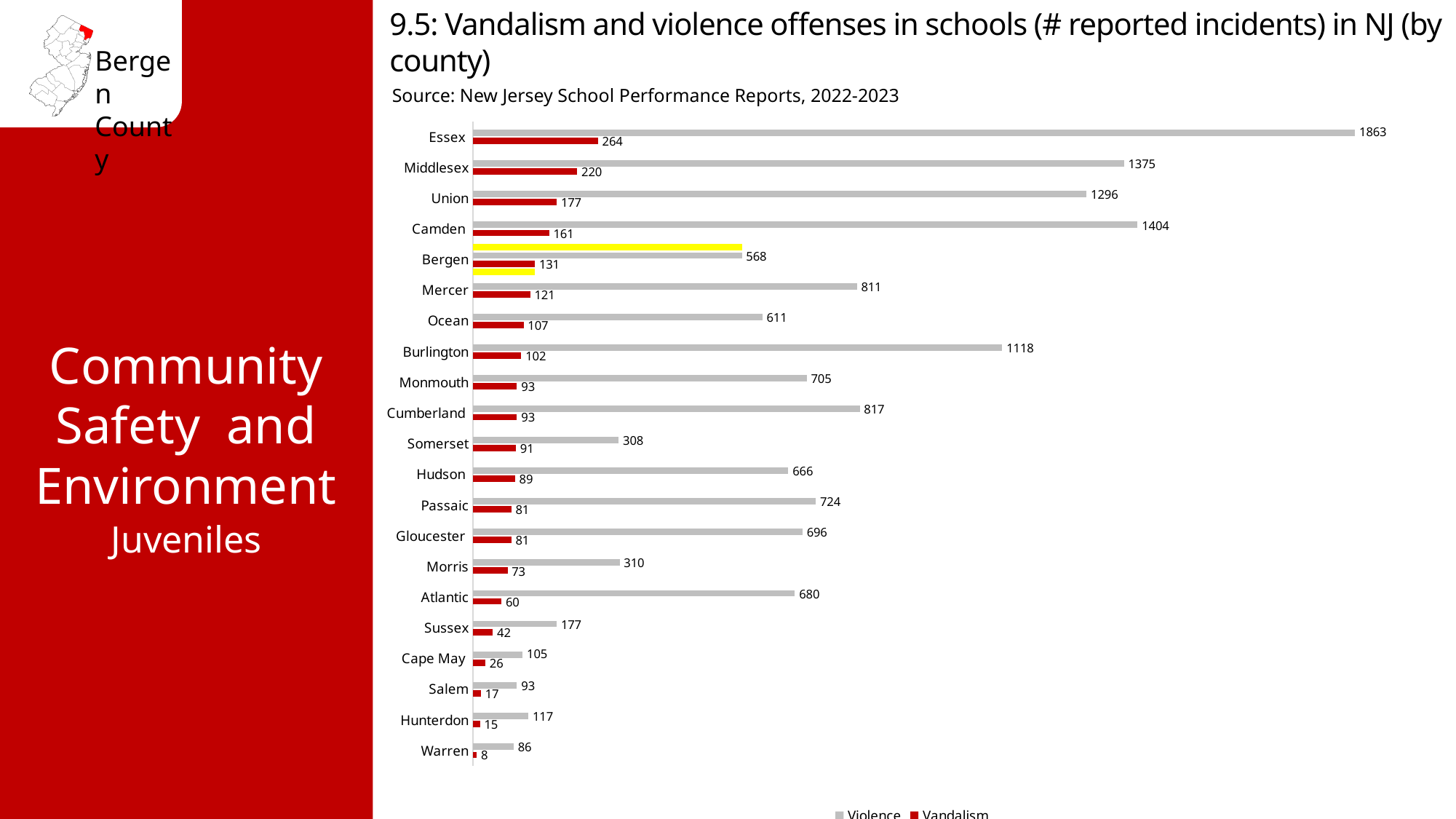
What is the number of reported violence incidents for Bergen County? 568 How many counties are shown in the chart? 21 Which county has the lowest number of reported vandalism incidents? Warren What is the difference between the vandalism incidents for Essex and Bergen? 133 Which county has the highest number of reported violence incidents? Essex What kind of chart is shown on the slide? Bar chart Which county has more reported violence incidents, Mercer or Cumberland? Cumberland Which series is shown in red in the chart? Vandalism What is the number of reported violence incidents for Burlington County? 1118 What is the difference between the violence incidents for Camden and Union? 108 How many series does the legend list? 2 What is the number of reported vandalism incidents for Middlesex County? 220